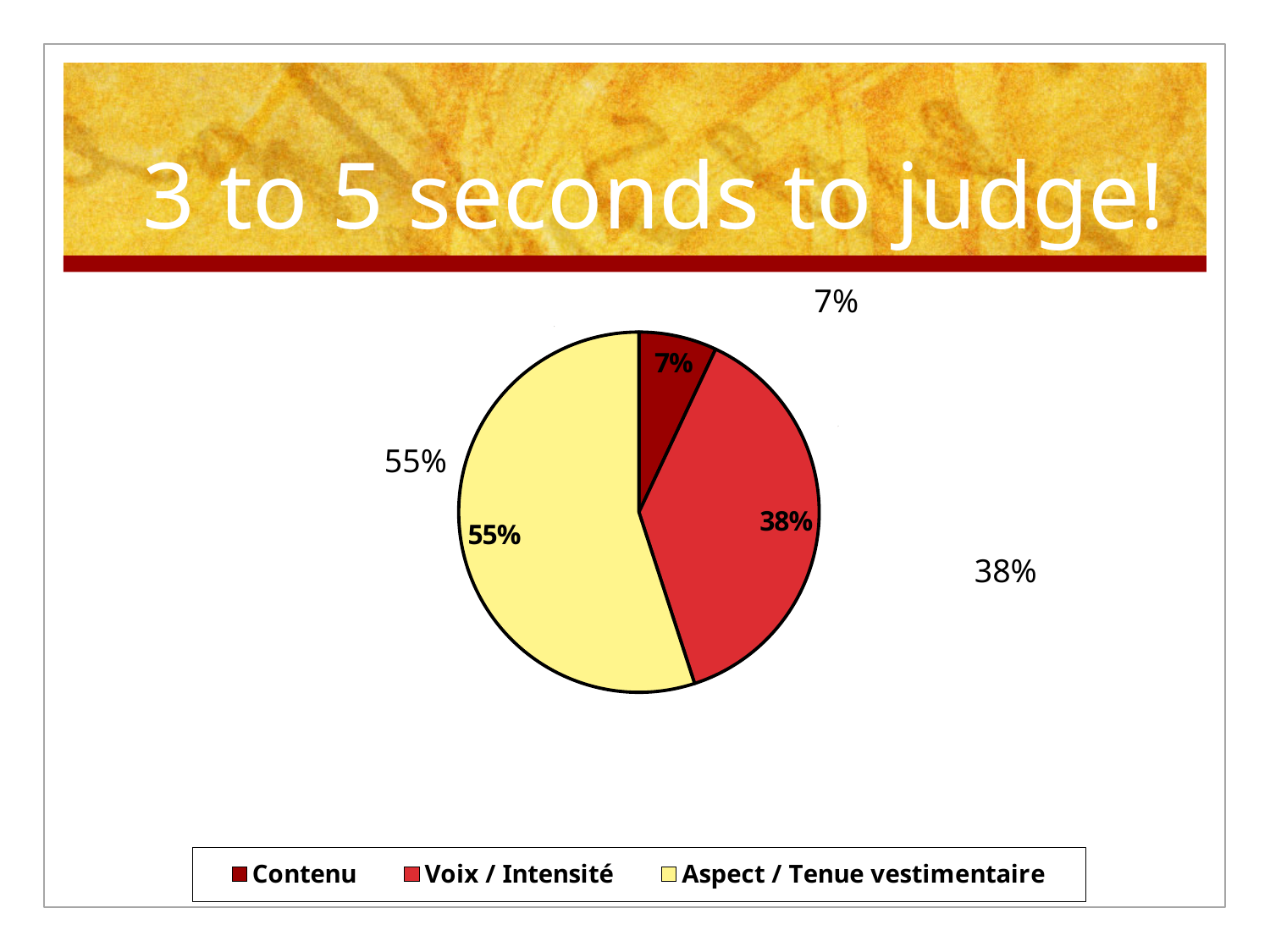
What share of the pie does Contenu represent? 7% What kind of chart is shown on the slide? pie chart What colour is the slice for Aspect / Tenue vestimentaire? light yellow What share of the pie does Voix / Intensité represent? 38% What is the difference in percentage points between Aspect / Tenue vestimentaire and Voix / Intensité? 17% What is the title of the slide containing the pie chart? 3 to 5 seconds to judge! Which category has the smallest slice of the pie? Contenu What share of the pie does Aspect / Tenue vestimentaire represent? 55% How many categories does the pie chart have? 3 Which category has the largest slice of the pie? Aspect / Tenue vestimentaire Which is larger, the slice for Voix / Intensité or the slice for Contenu? Voix / Intensité What is the difference in percentage points between Voix / Intensité and Contenu? 31%